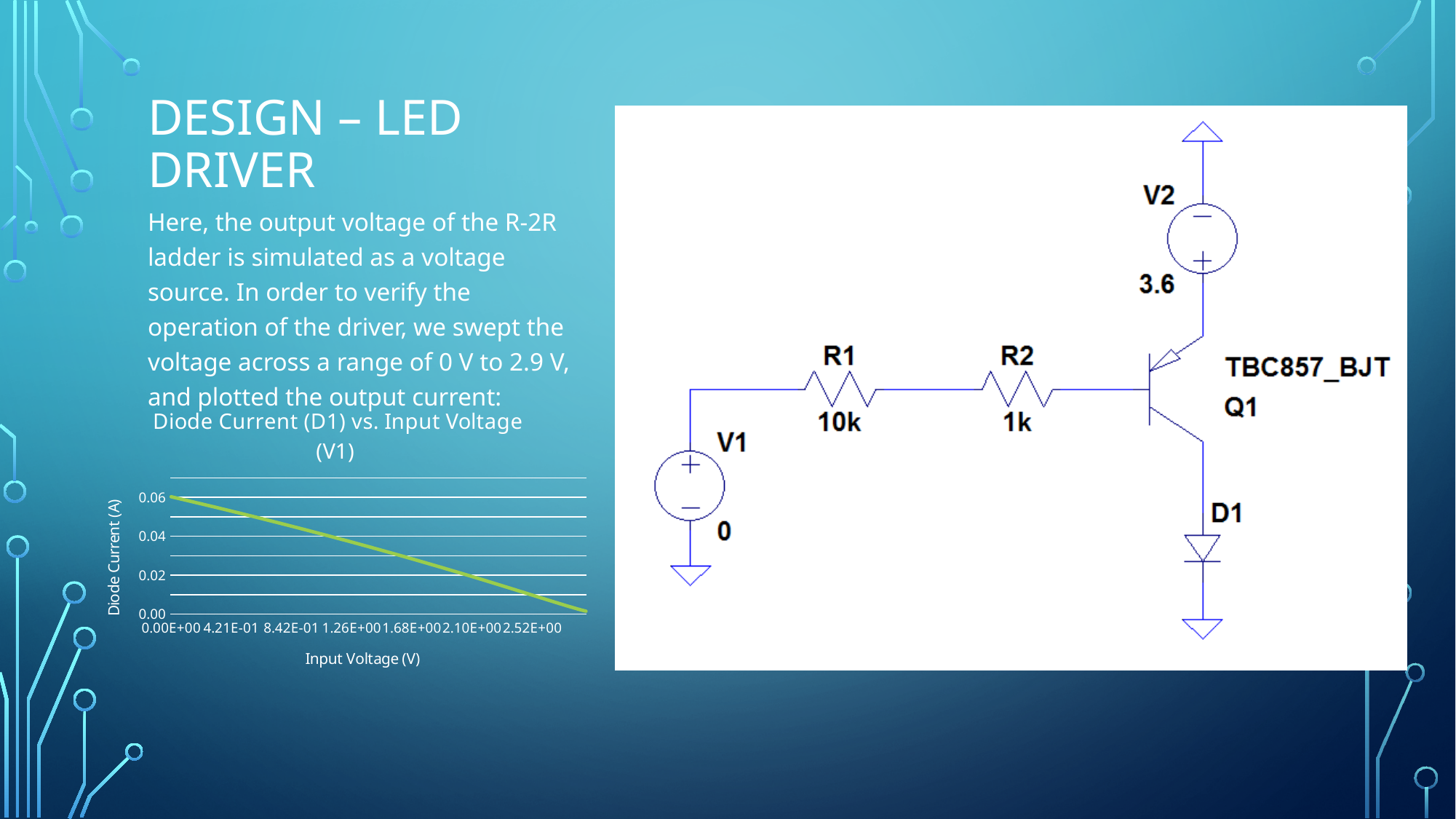
How many labeled tick values are shown on the x axis of the chart? 7 Does the diode current rise or fall as the input voltage increases along the x axis? fall Is the diode current at an input voltage of 1.26E+00 greater or less than 0.04? less Is the diode current at an input voltage of 2.52E+00 greater or less than 0.02? less What is the label of the vertical axis of the chart? Diode Current (A) At which labeled input voltage on the x axis is the diode current highest? 0.00E+00 Which is larger: the diode current at 4.21E-01 V or at 2.10E+00 V? 4.21E-01 V What is the title of the chart on the slide? Diode Current (D1) vs. Input Voltage (V1) What kind of chart is shown on the slide? line chart Is the diode current at an input voltage of 1.26E+00 greater or less than 0.02? greater